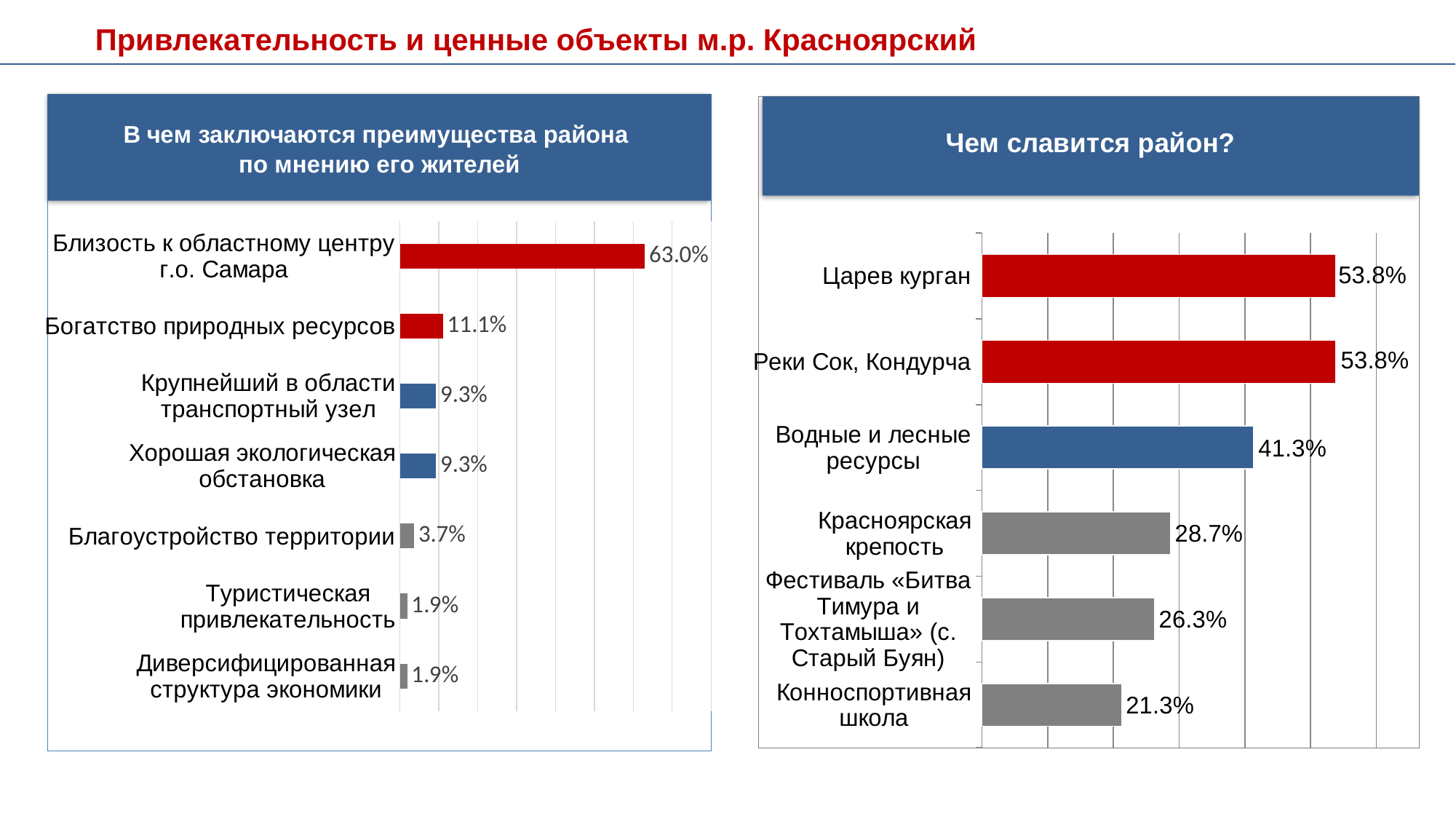
In the left chart 'В чем заключаются преимущества района по мнению его жителей', what is the value for 'Благоустройство территории'? 3.7% In the left chart 'В чем заключаются преимущества района по мнению его жителей', which category has the highest value? Близость к областному центру г.о. Самара In the right chart 'Чем славится район?', what is the value for 'Водные и лесные ресурсы'? 41.3% In the left chart 'В чем заключаются преимущества района по мнению его жителей', what is the difference between 'Близость к областному центру г.о. Самара' and 'Богатство природных ресурсов'? 51.9% In the right chart 'Чем славится район?', which is larger: 'Водные и лесные ресурсы' or 'Красноярская крепость'? Водные и лесные ресурсы In the left chart 'В чем заключаются преимущества района по мнению его жителей', how many categories are shown? 7 In the left chart 'В чем заключаются преимущества района по мнению его жителей', what is the value for 'Близость к областному центру г.о. Самара'? 63.0% What type of chart is the right chart 'Чем славится район?'? Bar chart In the right chart 'Чем славится район?', which category has the lowest value? Конноспортивная школа In the left chart 'В чем заключаются преимущества района по мнению его жителей', what is the value for 'Богатство природных ресурсов'? 11.1% In the right chart 'Чем славится район?', what is the difference between 'Царев курган' and 'Конноспортивная школа'? 32.5% In the right chart 'Чем славится район?', what is the value for 'Красноярская крепость'? 28.7%